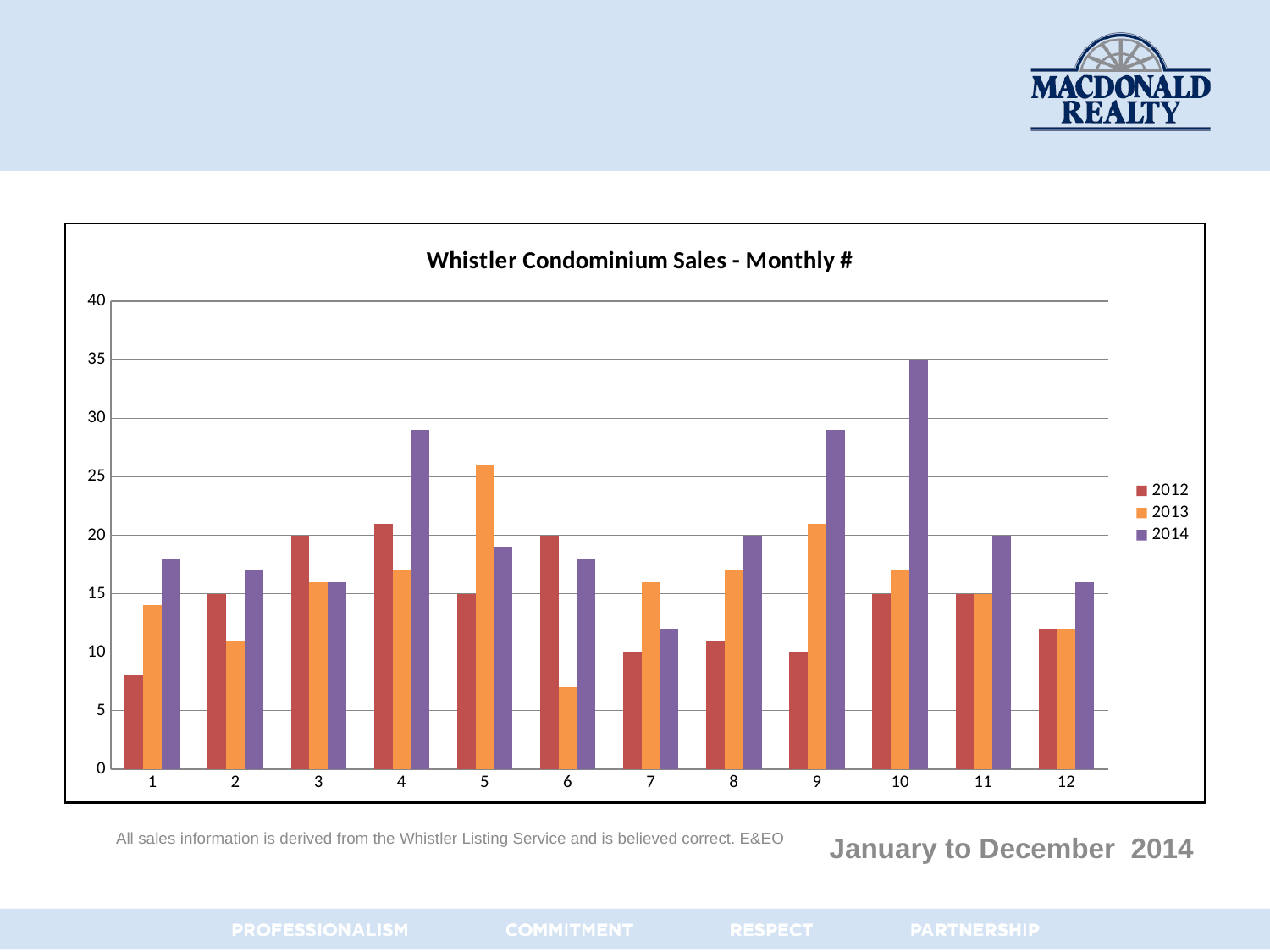
What is the value for 2012 in month 3? 20 Is the value for 2012 in month 1 greater or less than 10? less In which month does the 2013 series have its lowest value? 6 What is the title of the chart? Whistler Condominium Sales - Monthly # What is the value for 2014 in month 10? 35 What kind of chart is shown on the slide? bar chart Is the value for 2013 in month 5 greater or less than 25? greater How many series does the legend list? 3 In month 6, which series has the larger value, 2012 or 2013? 2012 How many months (categories) are shown on the x axis? 12 In month 9, which series has the larger value, 2012 or 2014? 2014 In which month does the 2014 series reach its highest value? 10